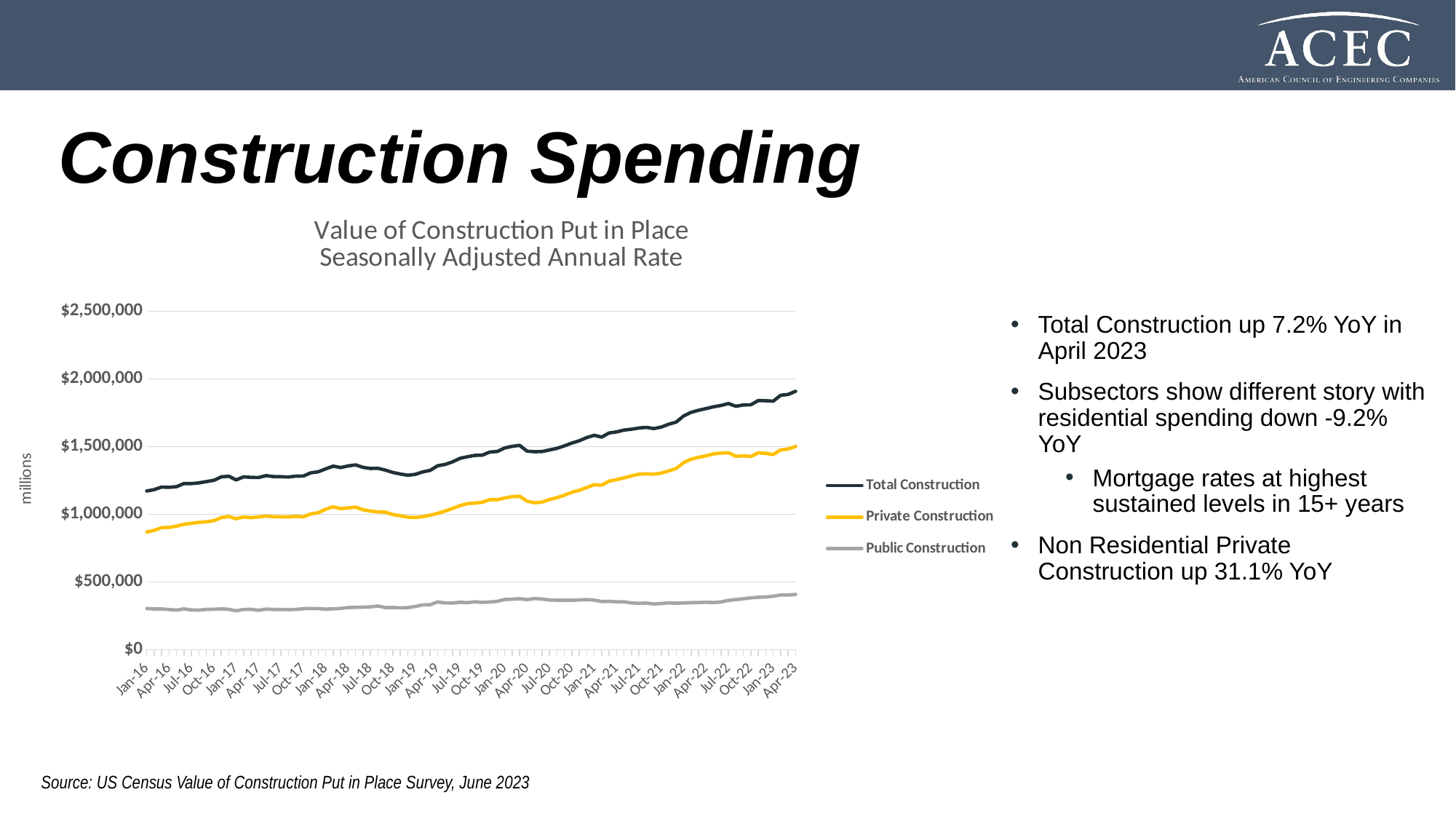
Which series has the highest values throughout the chart? Total Construction What unit label is shown on the chart's vertical axis? millions Does the Total Construction line rise or fall overall from Jan-16 to Apr-23? Rise Which series has the lowest values throughout the chart? Public Construction How many series does the chart's legend list? 3 What is the title of the chart? Value of Construction Put in Place Seasonally Adjusted Annual Rate Is the value for Total Construction at Apr-23 greater or less than $1,500,000? greater At Apr-23, which is larger: Private Construction or Public Construction? Private Construction What kind of chart is shown on the slide? Line chart Is the value for Total Construction at Jan-16 greater or less than $1,000,000? greater Is the value for Private Construction at Jan-16 greater or less than $1,000,000? less